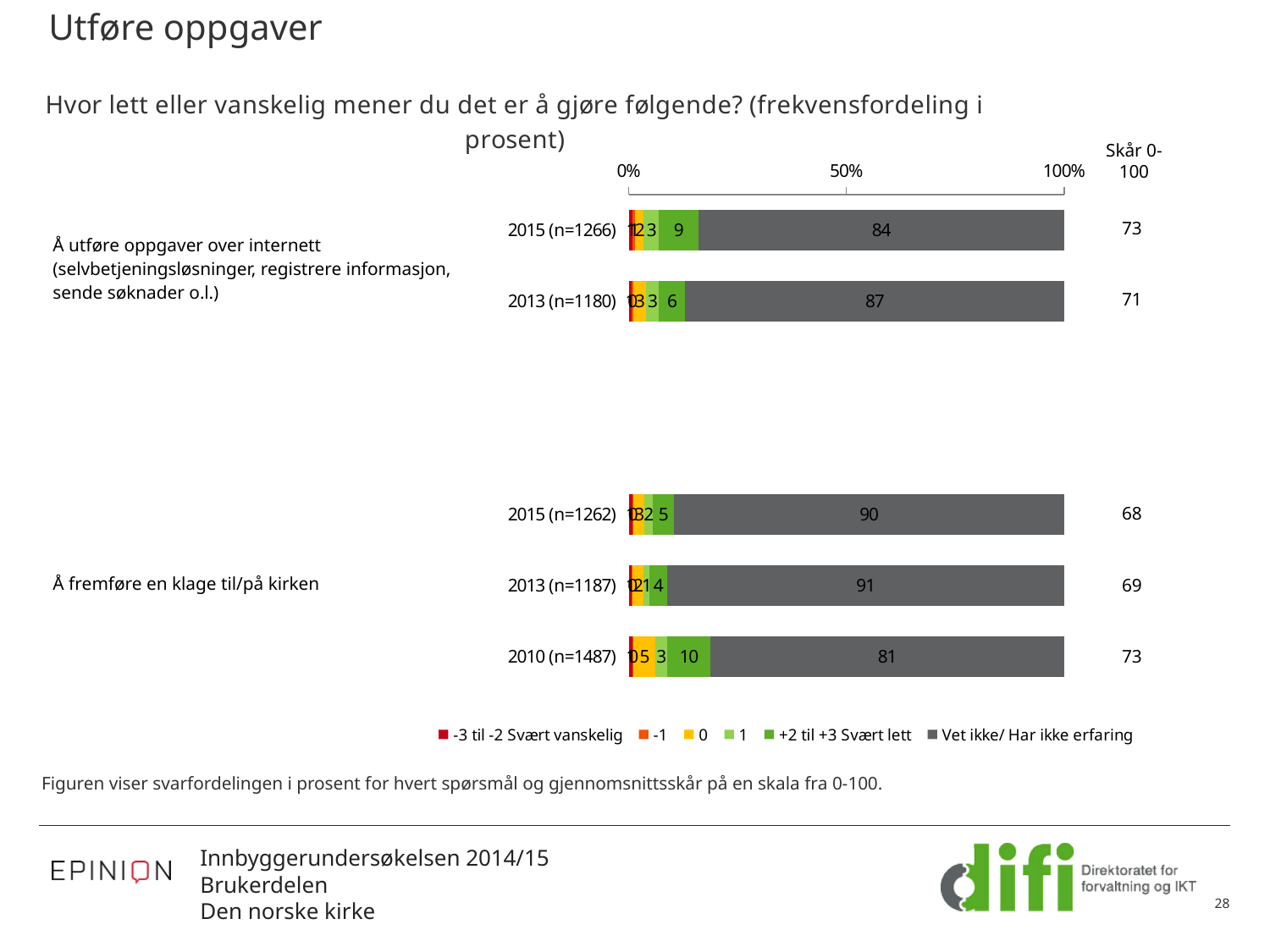
Which is larger, the '+2 til +3 Svært lett' value for 2015 (n=1266) or for 2013 (n=1180) under 'Å utføre oppgaver over internett'? 2015 (n=1266) What is the Skår 0-100 value shown for 2013 (n=1180) under 'Å utføre oppgaver over internett'? 71 Is the 'Vet ikke/ Har ikke erfaring' value for 2015 (n=1262) greater or less than 50%? greater What kind of chart is shown on the slide? Stacked bar chart What is the difference between the 'Vet ikke/ Har ikke erfaring' values for 2013 (n=1180) and 2015 (n=1266) under 'Å utføre oppgaver over internett'? 3 How many series does the legend list? 6 What is the value of the 'Vet ikke/ Har ikke erfaring' segment for 2010 (n=1487) under 'Å fremføre en klage til/på kirken'? 81 Which bar has the lowest 'Vet ikke/ Har ikke erfaring' value? 2010 (n=1487) How many bars are plotted in the chart? 5 What is the '+2 til +3 Svært lett' value for 2010 (n=1487) under 'Å fremføre en klage til/på kirken'? 10 Which bar has the highest 'Vet ikke/ Har ikke erfaring' value? 2013 (n=1187) What is the value of the 'Vet ikke/ Har ikke erfaring' segment for 2015 (n=1266) under 'Å utføre oppgaver over internett'? 84